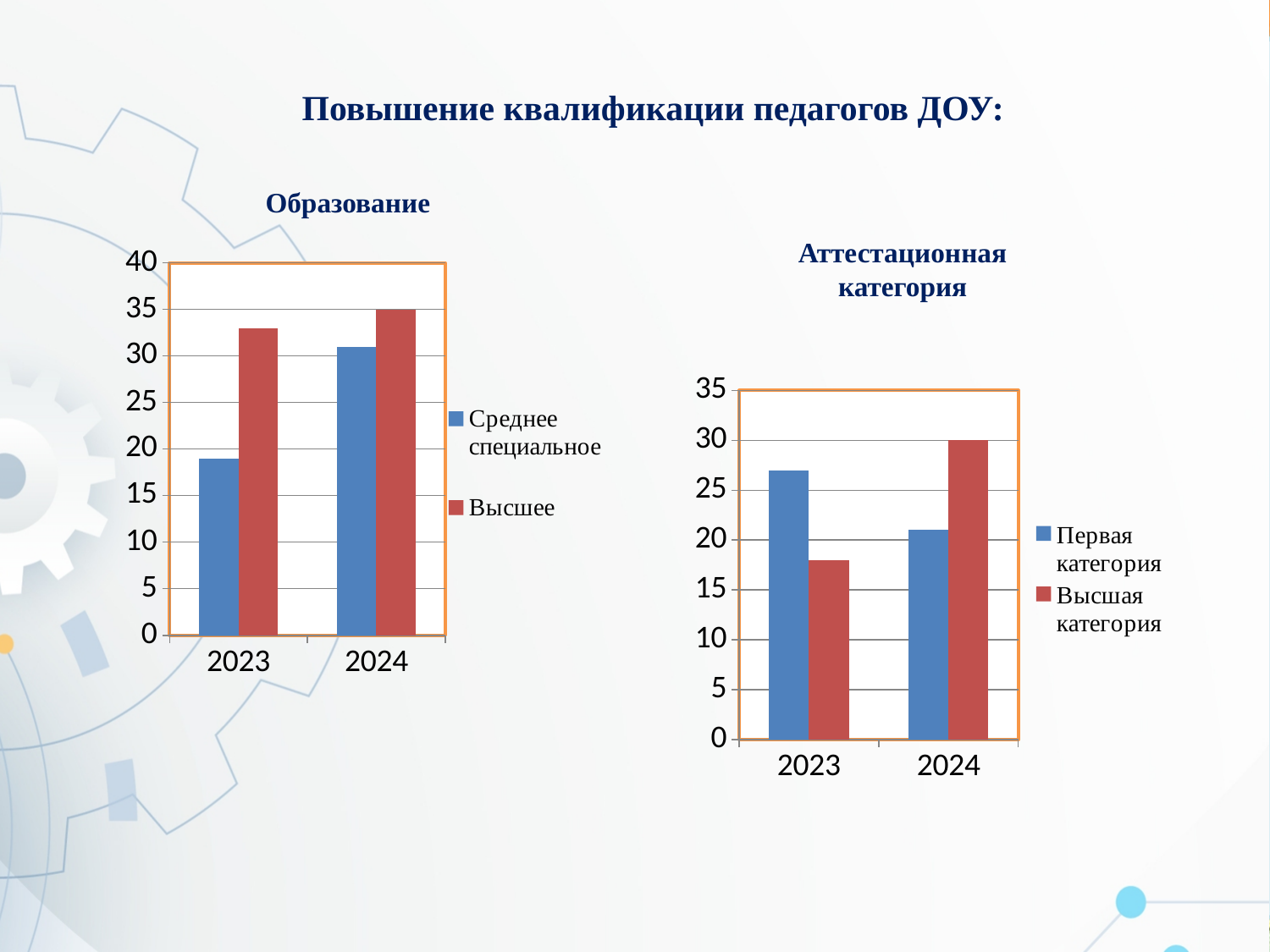
In the "Образование" chart, does the value for Среднее специальное rise or fall from 2023 to 2024? rise In the "Образование" chart, what is the value for Высшее in 2024? 35 In the "Образование" chart, is the value for Высшее in 2023 greater or less than 30? greater In the "Аттестационная категория" chart, which series is larger in 2023, Первая категория or Высшая категория? Первая категория In the "Образование" chart, is the value for Среднее специальное in 2023 greater or less than 20? less How many series does the legend of the "Образование" chart list? 2 In the "Образование" chart, which series is larger in 2024, Среднее специальное or Высшее? Высшее In the "Аттестационная категория" chart, what is the value for Высшая категория in 2024? 30 In the "Аттестационная категория" chart, does the value for Первая категория rise or fall from 2023 to 2024? fall What type of chart is the "Образование" chart? bar chart In the "Аттестационная категория" chart, is the value for Высшая категория in 2023 greater or less than 20? less How many categories are shown on the x axis of the "Аттестационная категория" chart? 2